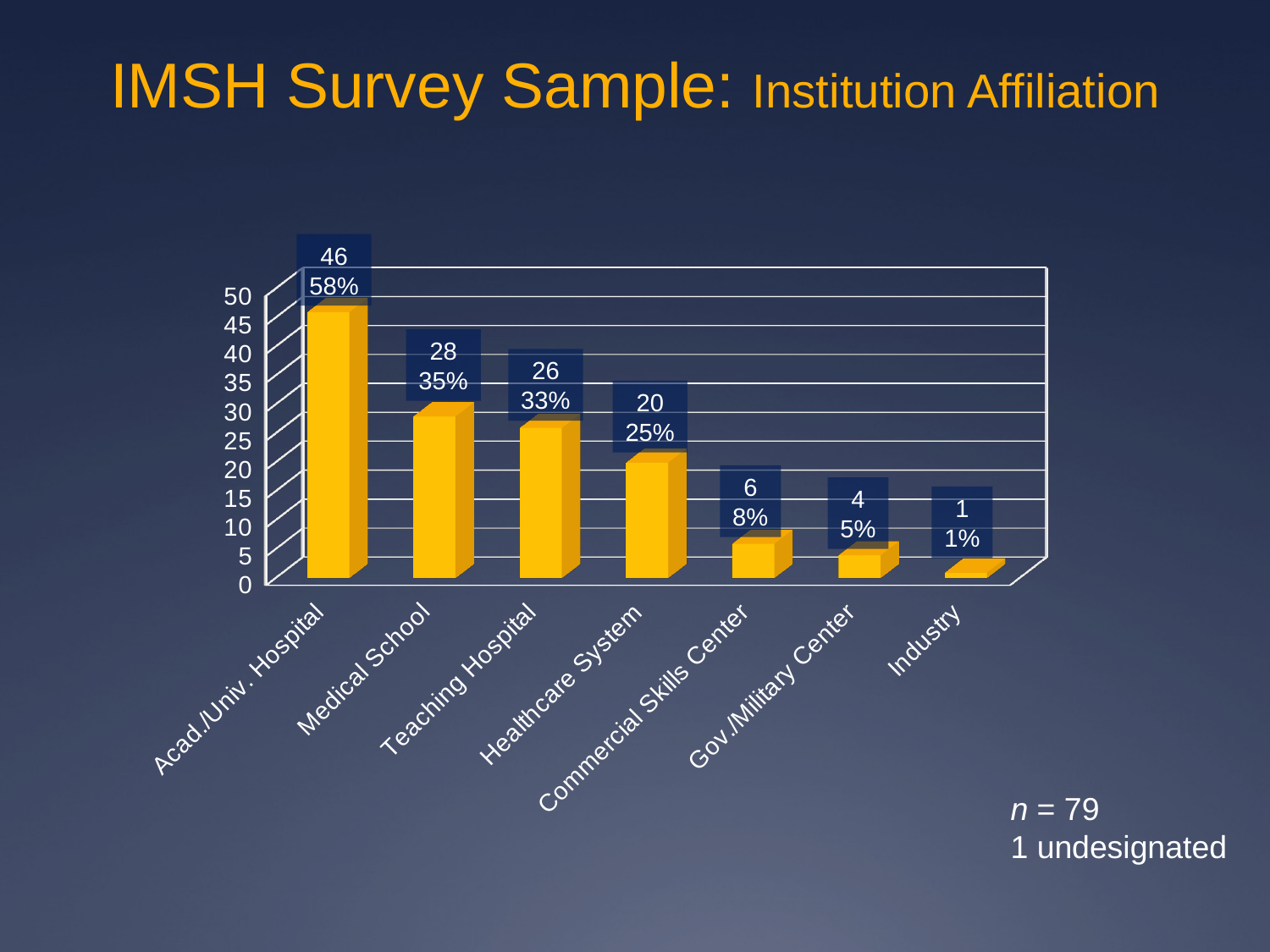
Which category has the lowest value? Industry What percentage is shown for Commercial Skills Center? 8% What is the value for Acad./Univ. Hospital? 46 What is the value for Healthcare System? 20 What percentage is shown for Medical School? 35% Do the values rise or fall from left to right along the x axis? fall How many categories are shown on the x axis? 7 What kind of chart is shown on the slide? bar chart Which is larger, the value for Teaching Hospital or the value for Healthcare System? Teaching Hospital Which category has the highest value? Acad./Univ. Hospital Is the value for Gov./Military Center greater or less than 10? less What is the difference between the values for Acad./Univ. Hospital and Medical School? 18